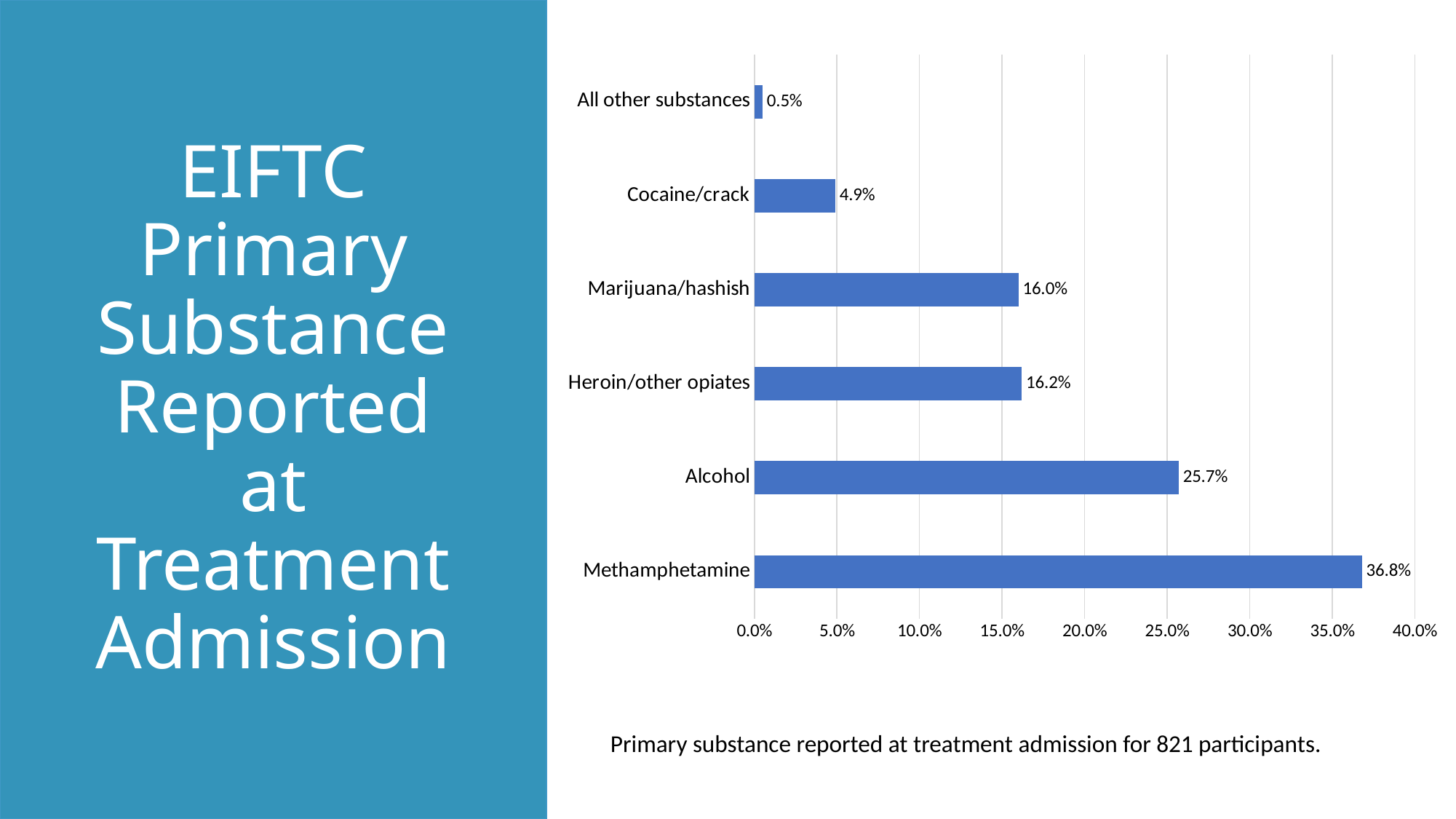
What is the difference between Heroin/other opiates and Marijuana/hashish? 0.2% What percentage of participants reported methamphetamine as their primary substance? 36.8% What type of chart is shown on the slide? Bar chart How many substance categories are shown in the chart? 6 What is the value shown for Alcohol? 25.7% According to the caption below the chart, how many participants are included? 821 What percentage is shown for Cocaine/crack? 4.9% What is the difference between the Methamphetamine and Alcohol percentages? 11.1% Which is larger, the value for Alcohol or the value for Marijuana/hashish? Alcohol What is the value for All other substances? 0.5% Which substance has the highest percentage? Methamphetamine Which category has the lowest percentage? All other substances